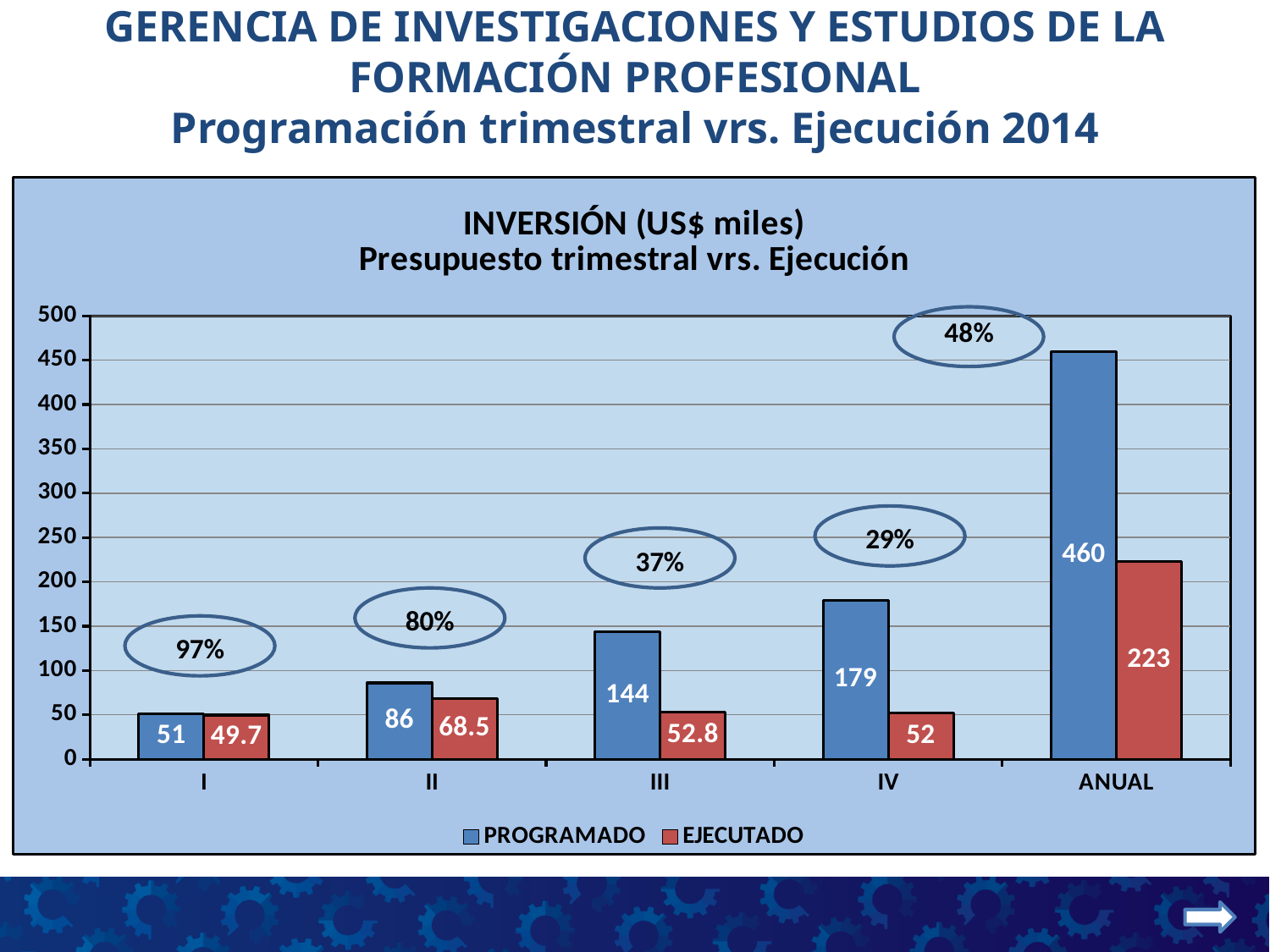
Which category has the lowest EJECUTADO value? I How many categories are shown on the x axis? 5 What percentage is shown in the circle above quarter III? 37% What is the EJECUTADO value for quarter II? 68.5 What is the difference between the PROGRAMADO and EJECUTADO values for quarter IV? 127 What kind of chart is shown? bar chart How many series does the legend list? 2 What is the EJECUTADO value for ANUAL? 223 Which is larger for quarter II: PROGRAMADO or EJECUTADO? PROGRAMADO What is the PROGRAMADO value for quarter III? 144 Which category has the highest PROGRAMADO value? ANUAL Is the PROGRAMADO value for ANUAL greater or less than 400? greater